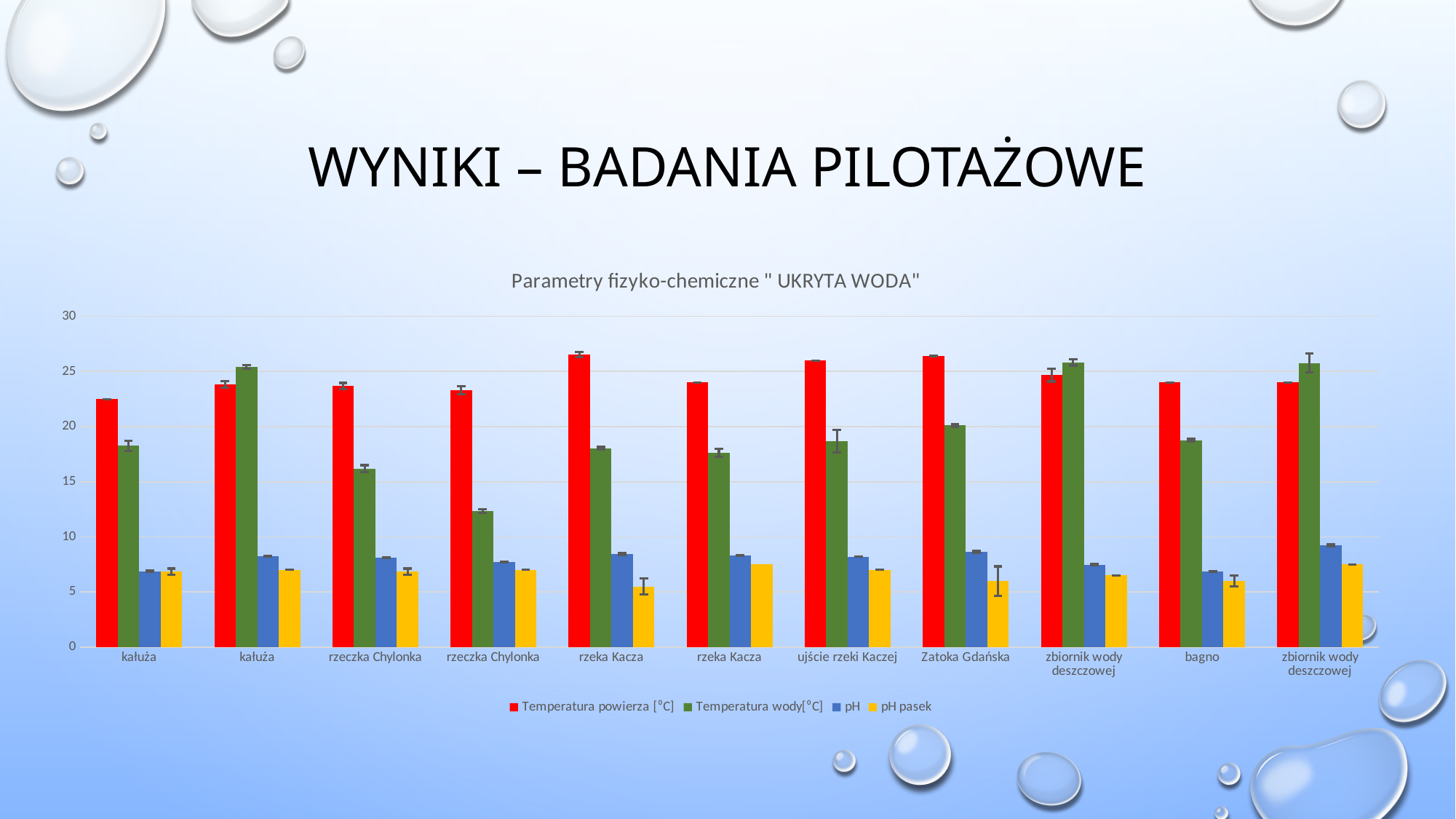
Is the Temperatura wody value for bagno greater or less than 20? less For the first rzeka Kacza category, which is larger: pH or pH pasek? pH Is the Temperatura wody value for the second rzeczka Chylonka category greater or less than 15? less What kind of chart is shown on the slide? bar chart How many categories are shown along the x axis? 11 What is the title of the chart? Parametry fizyko-chemiczne " UKRYTA WODA" Which category has the lowest Temperatura wody value? rzeczka Chylonka (second) Which category has the lowest Temperatura powierza value? kałuża (first) How many series does the legend list? 4 Is the Temperatura powierza value for the first rzeka Kacza category greater or less than 25? greater Which colour represents the pH pasek series? yellow